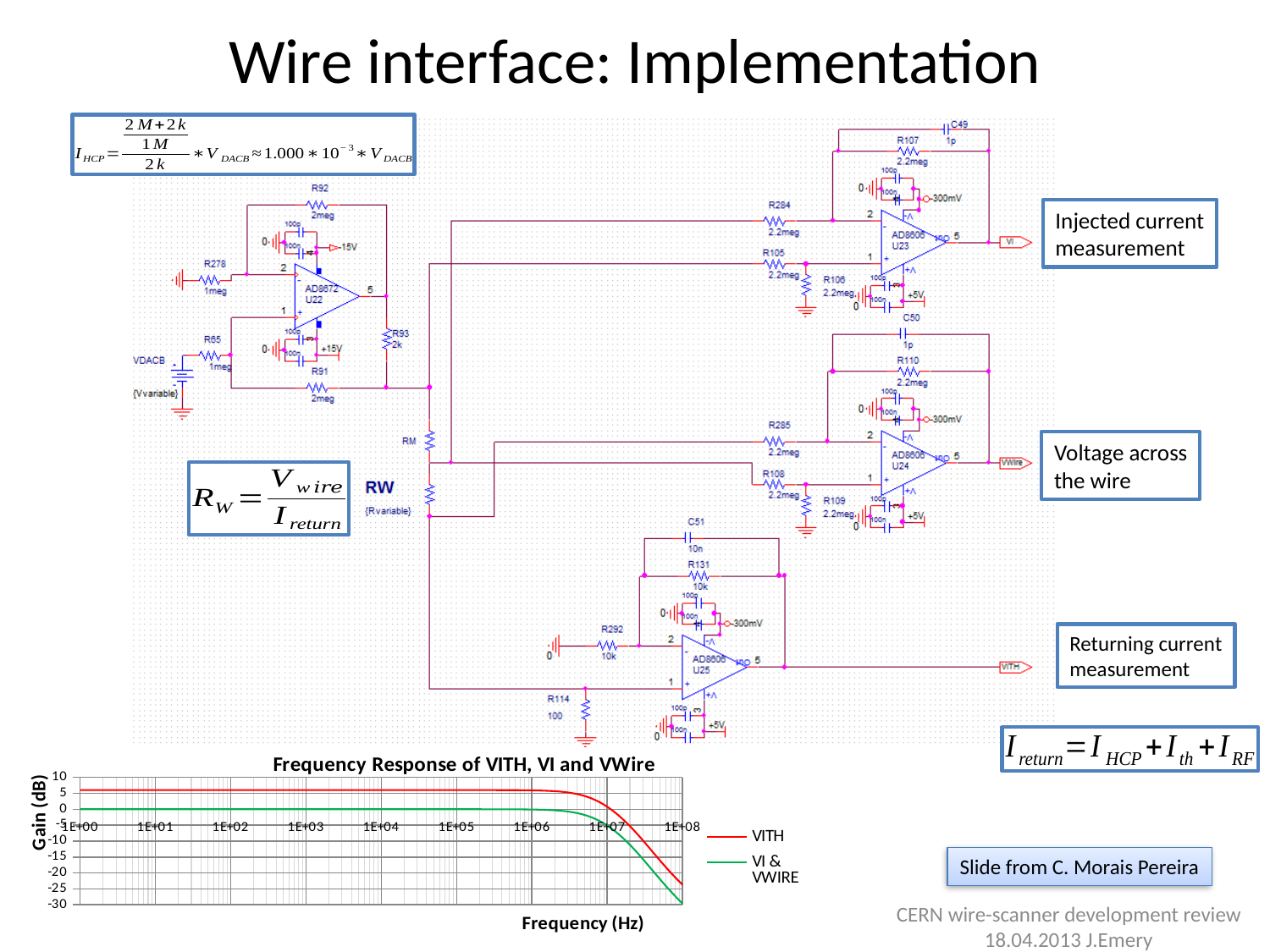
What is the title of the chart at the bottom of the slide? Frequency Response of VITH, VI and VWire How many series does the legend of the frequency response chart list? 2 What kind of chart is shown at the bottom of the slide? line chart In the frequency response chart, is the gain of VI & VWIRE at 1E+03 Hz greater or less than 5 dB? less In the frequency response chart, which series has the higher gain at low frequencies, VITH or VI & VWIRE? VITH What is the label of the y axis of the frequency response chart? Gain (dB) In the frequency response chart, is the gain of VITH at 1E+03 Hz greater or less than 0 dB? greater In the frequency response chart, does the gain of VI & VWIRE rise, fall or stay flat between 1E+00 and 1E+05 Hz? stay flat In the frequency response chart, does the gain of VITH rise or fall as frequency increases beyond 1E+07 Hz? fall In the frequency response chart, is the gain of VITH at 1E+08 Hz greater or less than -10 dB? less In the frequency response chart, which series has the lower gain at 1E+08 Hz, VITH or VI & VWIRE? VI & VWIRE